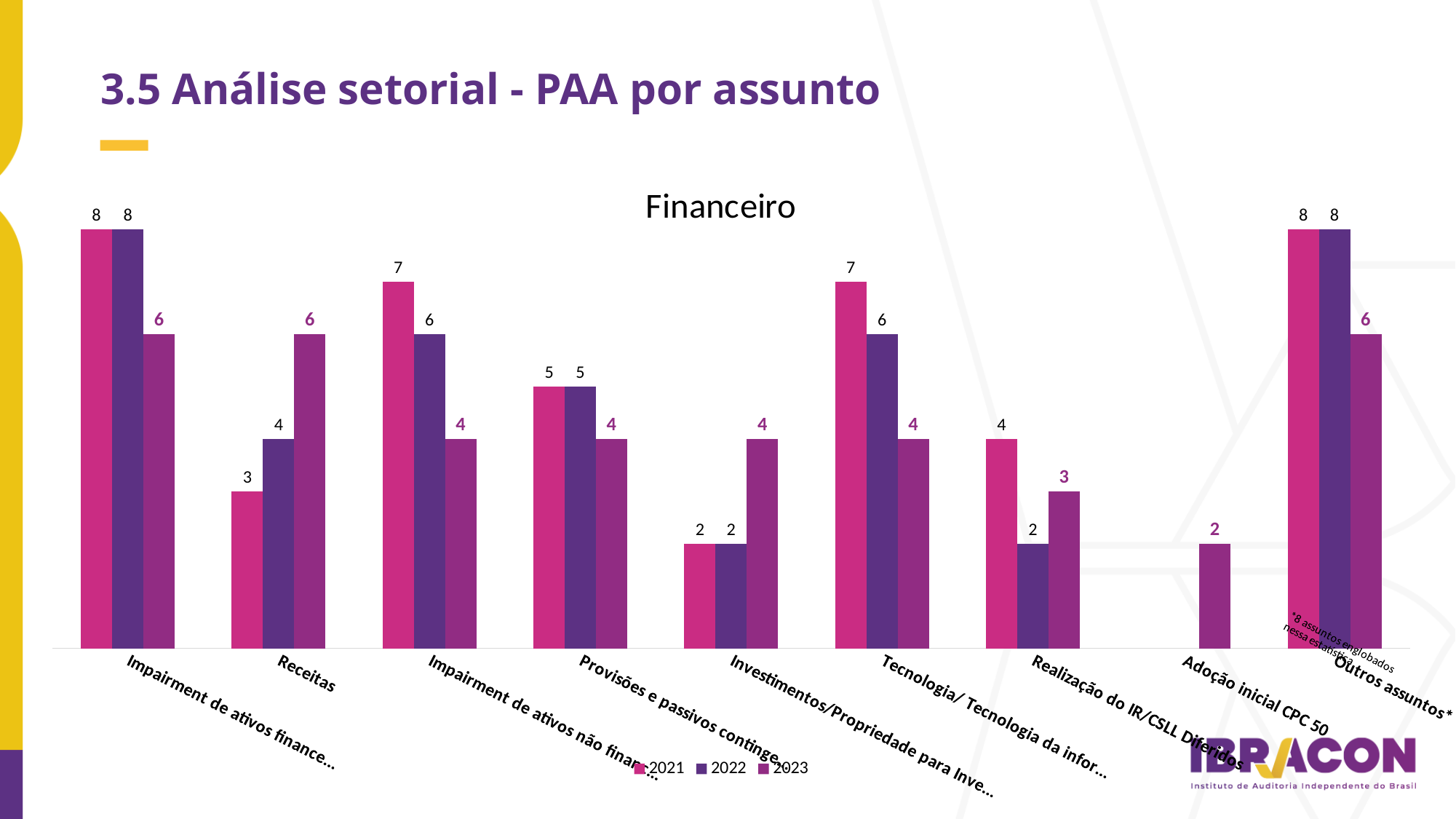
What is the title of the chart? Financeiro Which year has the highest value for Investimentos/Propriedade para Inve...? 2023 How many series does the legend list? 3 What is the 2022 value for Provisões e passivos continge...? 5 How many categories are shown on the x axis of the chart? 9 Which year has the lowest value for Receitas? 2021 What is the value for Adoção inicial CPC 50 in 2023? 2 Which is larger for Tecnologia/ Tecnologia da infor...: the 2021 value or the 2023 value? 2021 What is the value for Realização do IR/CSLL Diferidos in 2021? 4 What kind of chart is shown on the slide? bar chart What is the difference between the 2021 and 2023 values for Impairment de ativos não finan...? 3 What is the value for Receitas in 2023? 6